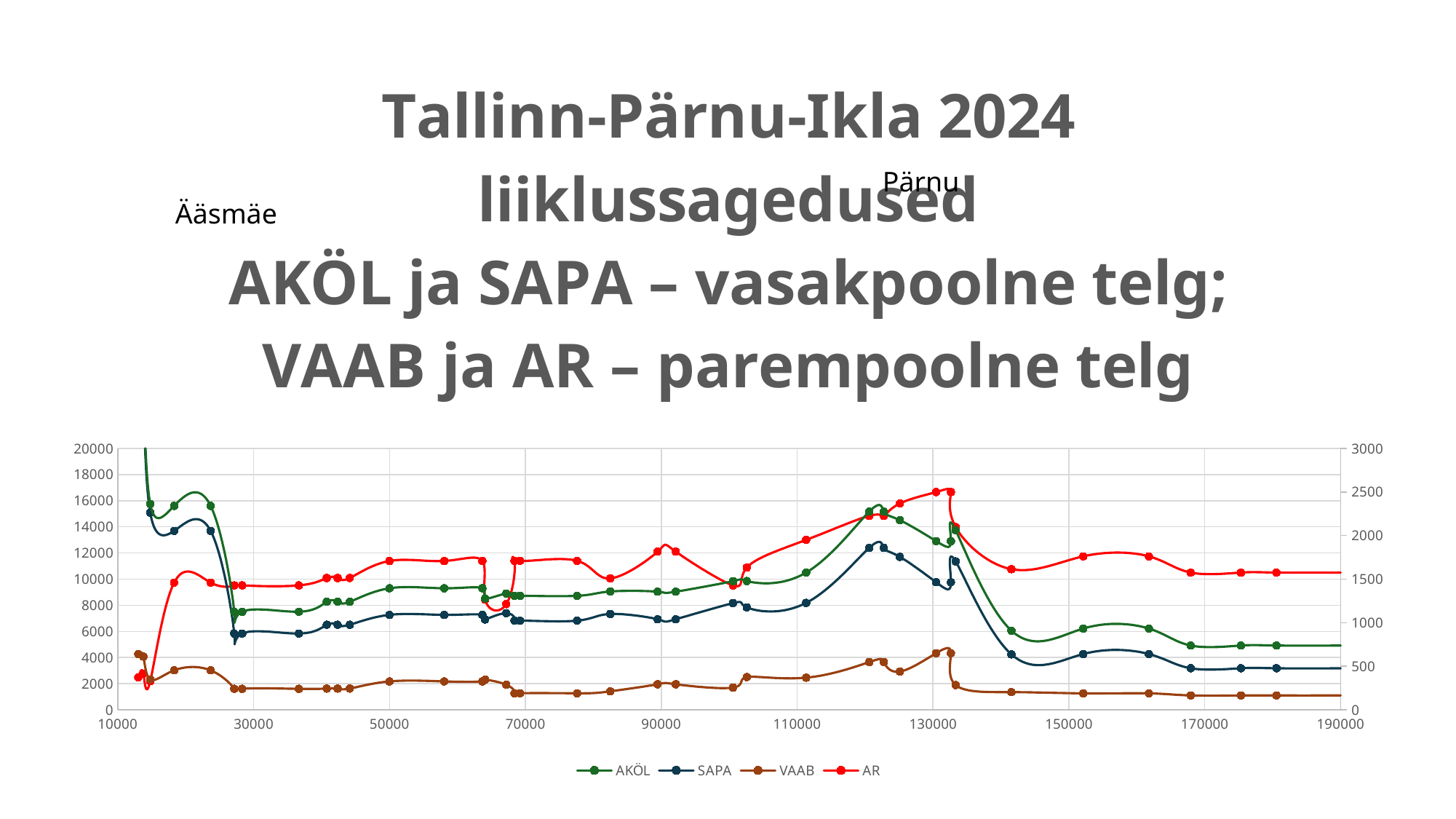
Is the AR value larger at x = 130000 or at x = 190000? 130000 Is the VAAB value at x = 190000 greater or less than 500 on the right axis? less What are the series names listed in the chart legend? AKÖL, SAPA, VAAB, AR Is the SAPA value at x = 120000 greater or less than 10000 on the left axis? greater What kind of chart is shown on the slide? line chart What is the highest tick value shown on the right-hand vertical axis? 3000 Is the AKÖL value at x = 30000 greater or less than 10000 on the left axis? less At x = 50000, which series has the higher value on the left axis, AKÖL or SAPA? AKÖL Between x = 130000 and x = 150000, does the AKÖL line rise or fall? fall How many series does the chart legend list? 4